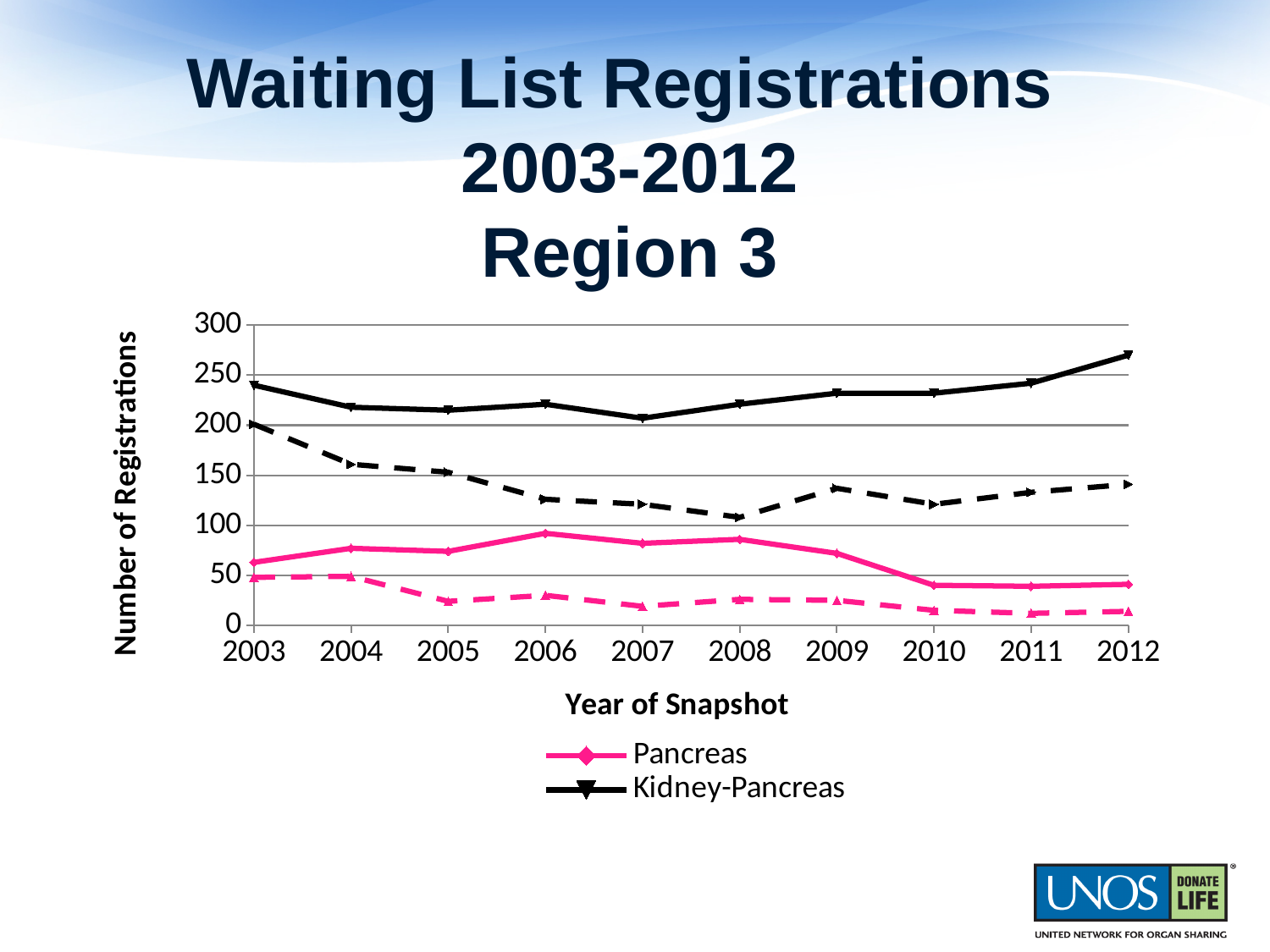
Is the Kidney-Pancreas value for 2007 greater or less than 250? less Is the Kidney-Pancreas value for 2012 greater or less than 250? greater What kind of chart is shown on the slide? line chart In which year is the Kidney-Pancreas series at its highest? 2012 In which year is the Pancreas series at its highest? 2006 Is the Pancreas value for 2006 greater or less than 100? less How many years are shown on the x axis? 10 Does the Pancreas series rise or fall from 2009 to 2010? fall Which series has the higher value in 2012, Pancreas or Kidney-Pancreas? Kidney-Pancreas How many series does the legend list? 2 What is the title of the x axis? Year of Snapshot